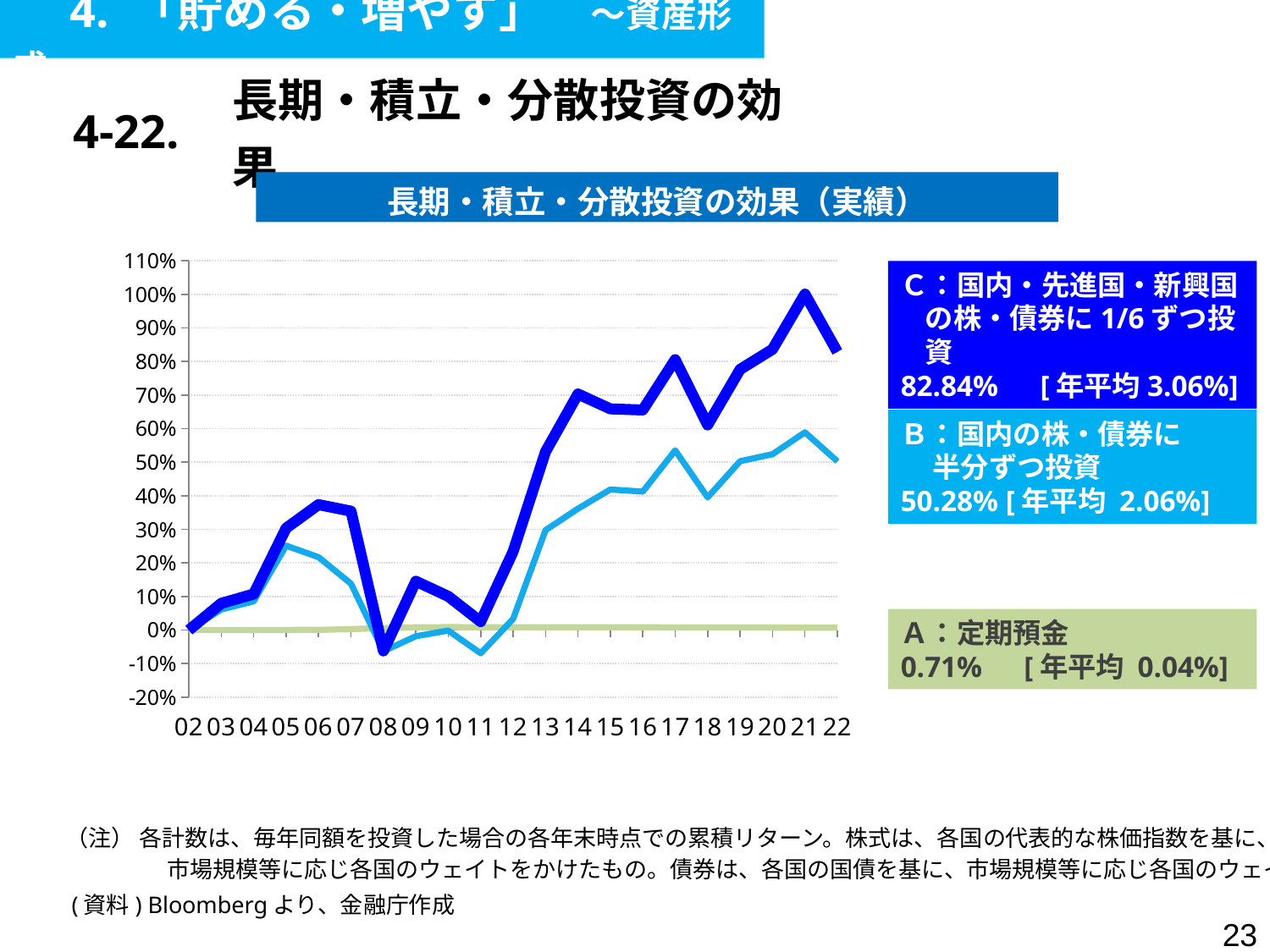
Which investment option has the highest cumulative return? C What is the cumulative return shown for C (国内・先進国・新興国の株・債券に1/6ずつ投資)? 82.84% How many investment options (series) are shown on the chart? 3 Which has the larger cumulative return, B or A? B What is the chart's title? 長期・積立・分散投資の効果（実績） What is the cumulative return shown for B (国内の株・債券に半分ずつ投資)? 50.28% What is the annual average return shown for C? 3.06% Is the value for C in 2021 greater or less than 90%? greater How many years are plotted along the x axis? 21 What kind of chart is shown on the slide? line chart What is the difference between the cumulative returns of C (82.84%) and B (50.28%)? 32.56% What is the cumulative return shown for A (定期預金)? 0.71%